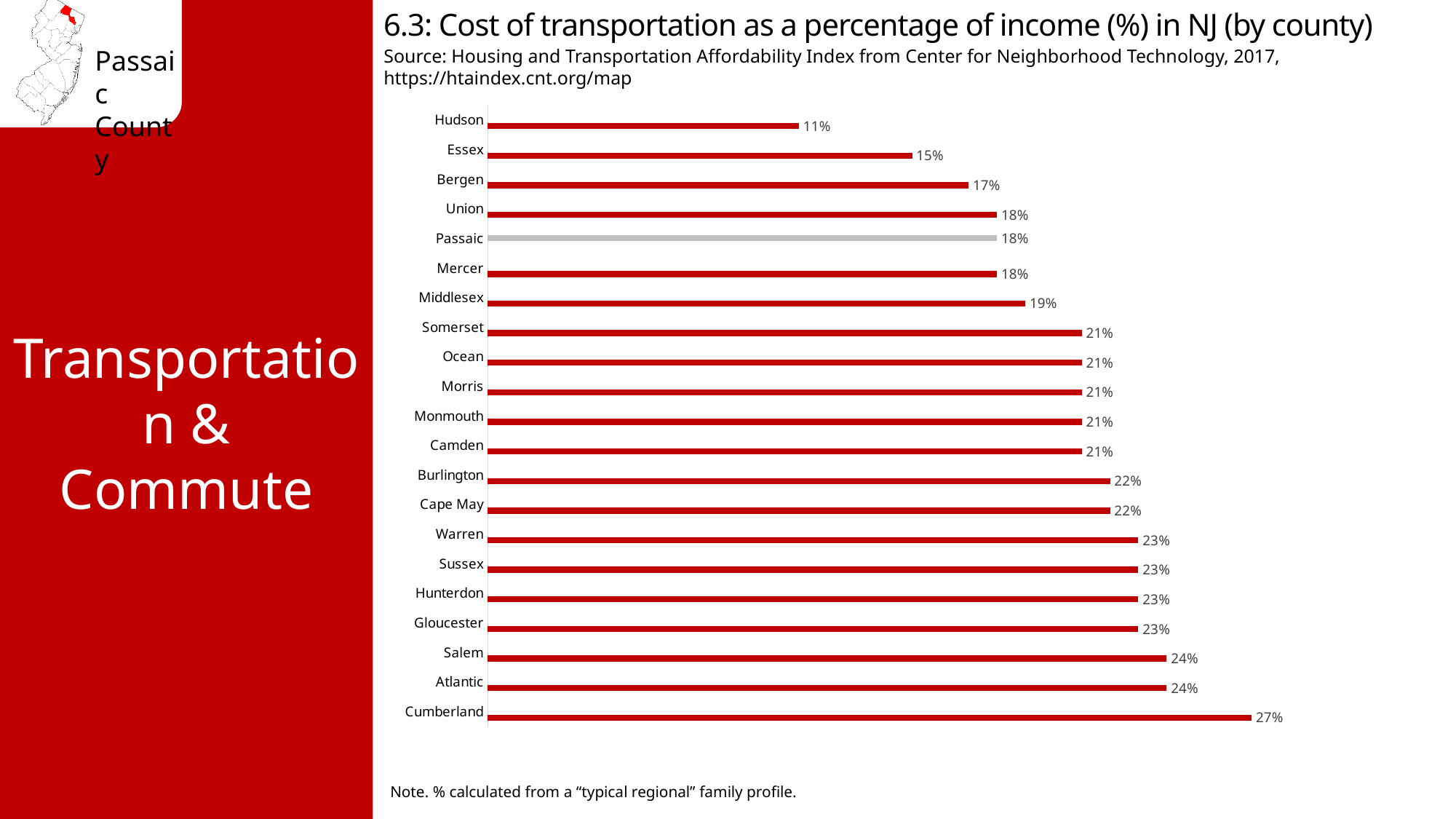
Which county has a larger value, Essex or Bergen? Bergen What is the value shown for Hudson county? 11% Which county has a larger value, Warren or Burlington? Warren What is the value shown for Middlesex county? 19% Which county has the lowest cost of transportation as a percentage of income? Hudson What is the difference between the values for Salem and Passaic? 6% What is the difference between the values for Cumberland and Hudson? 16% What is the cost of transportation as a percentage of income for Passaic county? 18% What type of chart is used on this slide? Bar chart Which county has the highest cost of transportation as a percentage of income? Cumberland How many counties are shown in the chart? 21 Which county's bar is shown in grey rather than red? Passaic